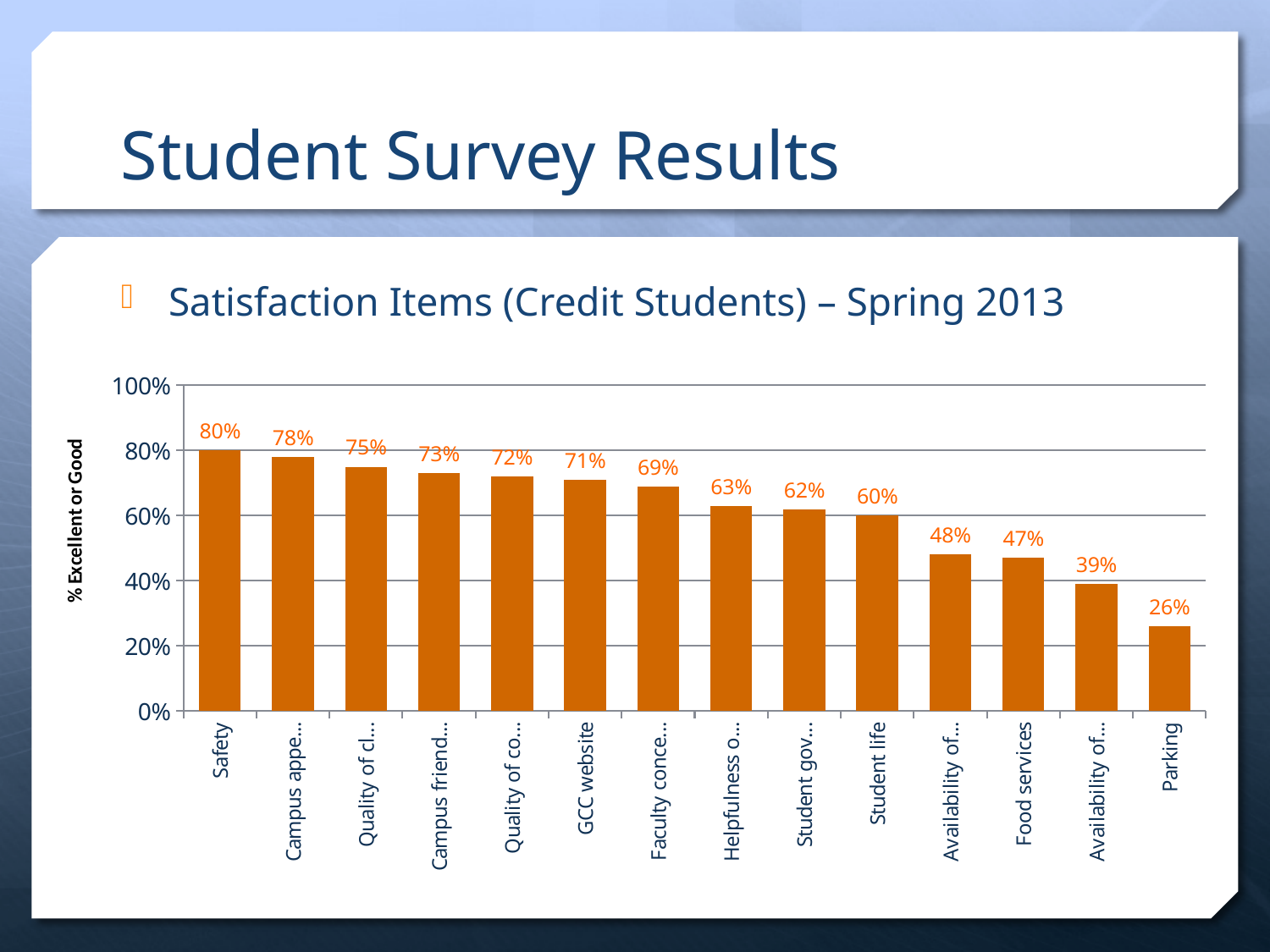
What percentage of credit students rated Safety as Excellent or Good? 80% What type of chart is shown on the slide? Bar chart What is the value shown for GCC website? 71% Which satisfaction item has the highest percentage of Excellent or Good ratings? Safety What is the difference in percentage points between Safety and Parking? 54 What is the value shown for Student life? 60% What is the value shown for Food services? 47% Which has a higher value, GCC website or Food services? GCC website Do the values rise or fall moving from left to right along the x axis? Fall What is the value shown for Parking? 26% Which satisfaction item has the lowest percentage of Excellent or Good ratings? Parking How many satisfaction items (bars) are shown in the chart? 14